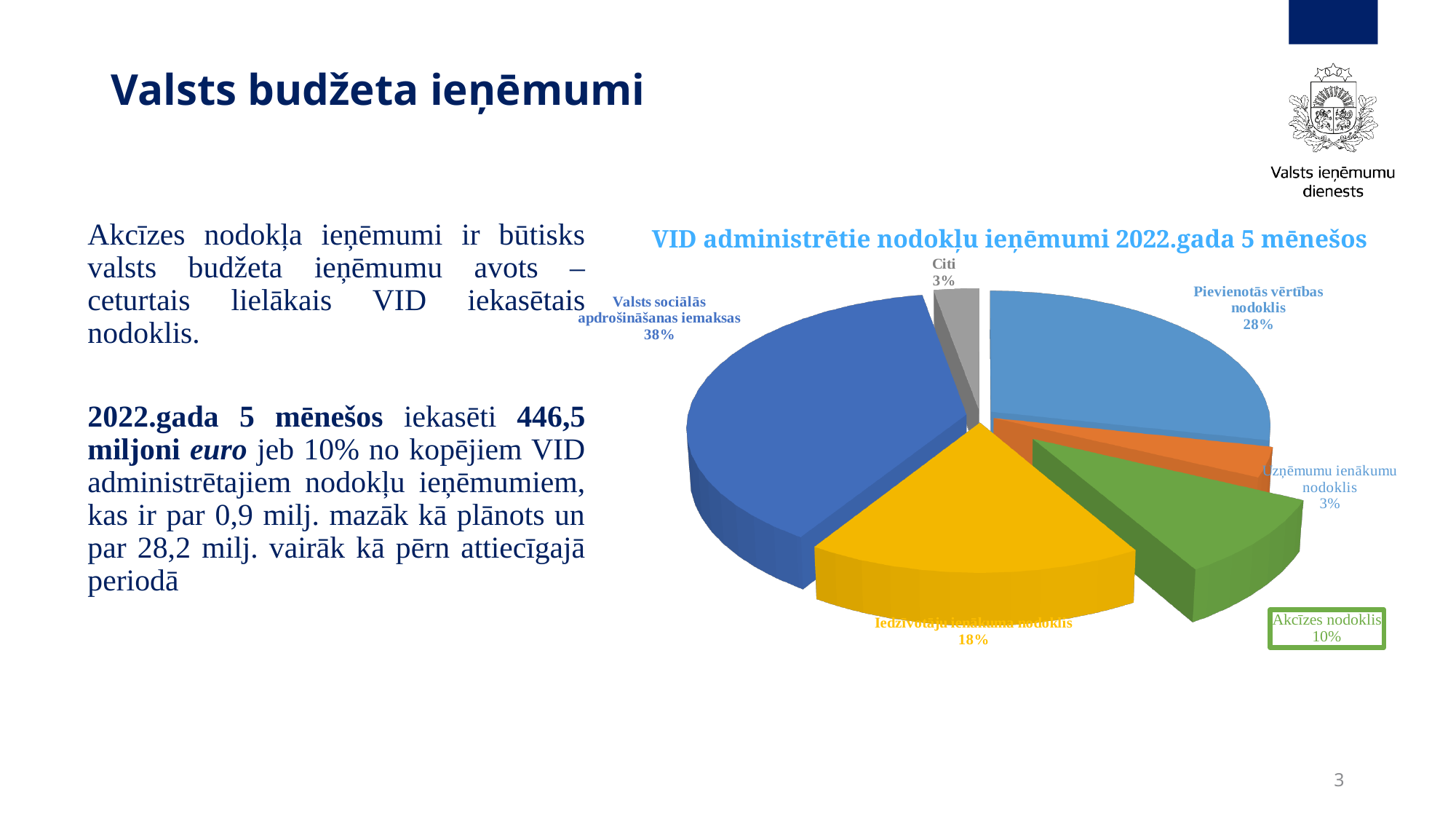
What share of the pie does Uzņēmumu ienākuma nodoklis represent? 3% What share of the pie does Pievienotās vērtības nodoklis represent? 28% What is the title of the chart? VID administrētie nodokļu ieņēmumi 2022.gada 5 mēnešos What share of the pie does Akcīzes nodoklis represent? 10% Which category has the largest share of the pie? Valsts sociālās apdrošināšanas iemaksas What is the difference in percentage points between Valsts sociālās apdrošināšanas iemaksas and Pievienotās vērtības nodoklis? 10 What colour is the Akcīzes nodoklis slice? Green How many slices does the pie chart have? 6 What kind of chart is shown on the slide? Pie chart Which is larger, the share for Iedzīvotāju ienākuma nodoklis or the share for Akcīzes nodoklis? Iedzīvotāju ienākuma nodoklis